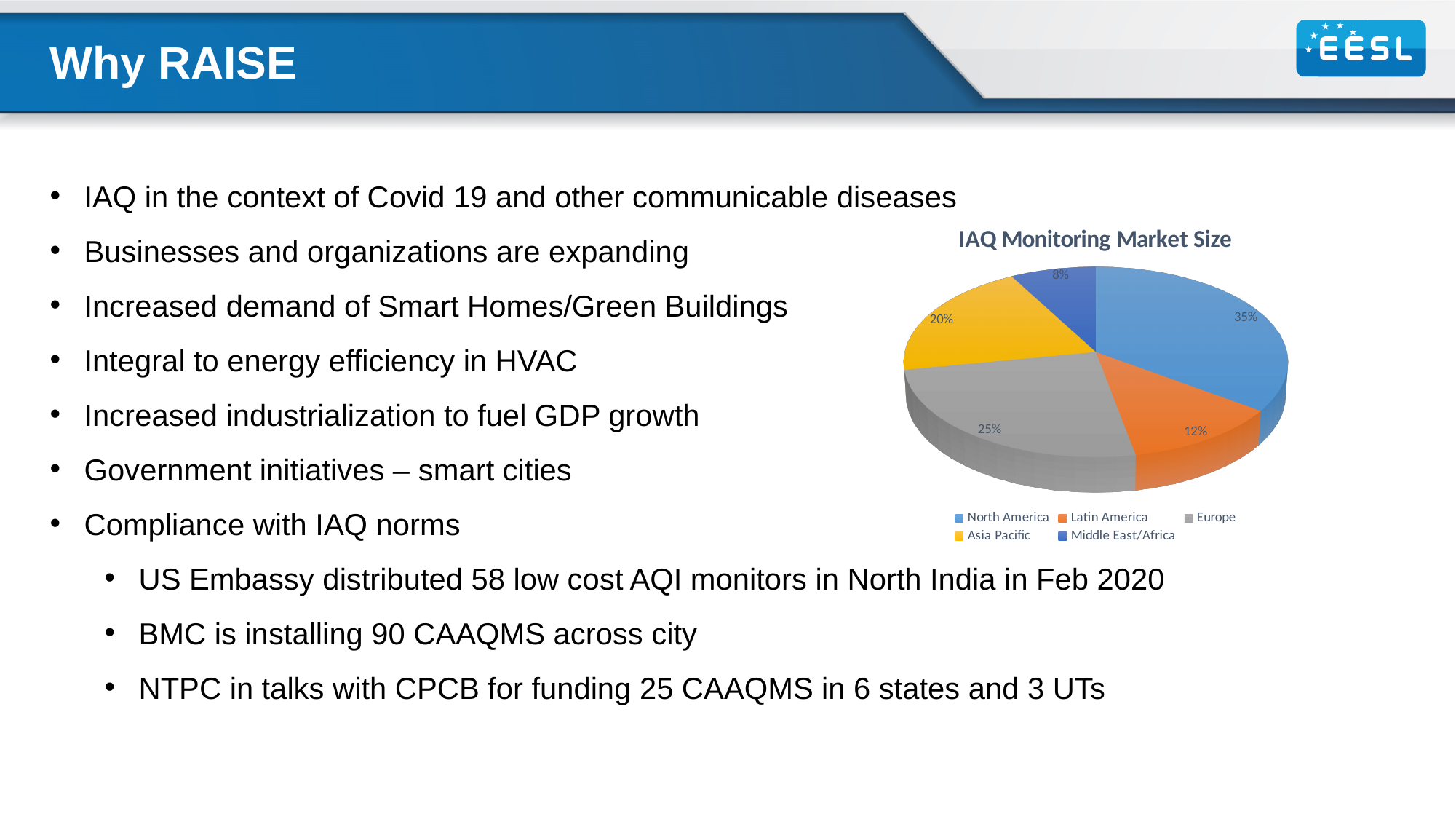
Which has a larger share, Asia Pacific or Latin America? Asia Pacific What is the title of the chart? IAQ Monitoring Market Size What share of the IAQ Monitoring Market Size pie does Europe hold? 25% What share of the IAQ Monitoring Market Size pie does Asia Pacific hold? 20% Which region has the largest slice in the IAQ Monitoring Market Size pie? North America What share of the IAQ Monitoring Market Size pie does North America hold? 35% What is the difference in percentage points between North America's and Europe's shares? 10 What share of the IAQ Monitoring Market Size pie does Latin America hold? 12% What kind of chart is shown on the slide? pie chart What share of the IAQ Monitoring Market Size pie does Middle East/Africa hold? 8% How many regions are shown in the IAQ Monitoring Market Size pie chart? 5 Which region has the smallest slice in the IAQ Monitoring Market Size pie? Middle East/Africa